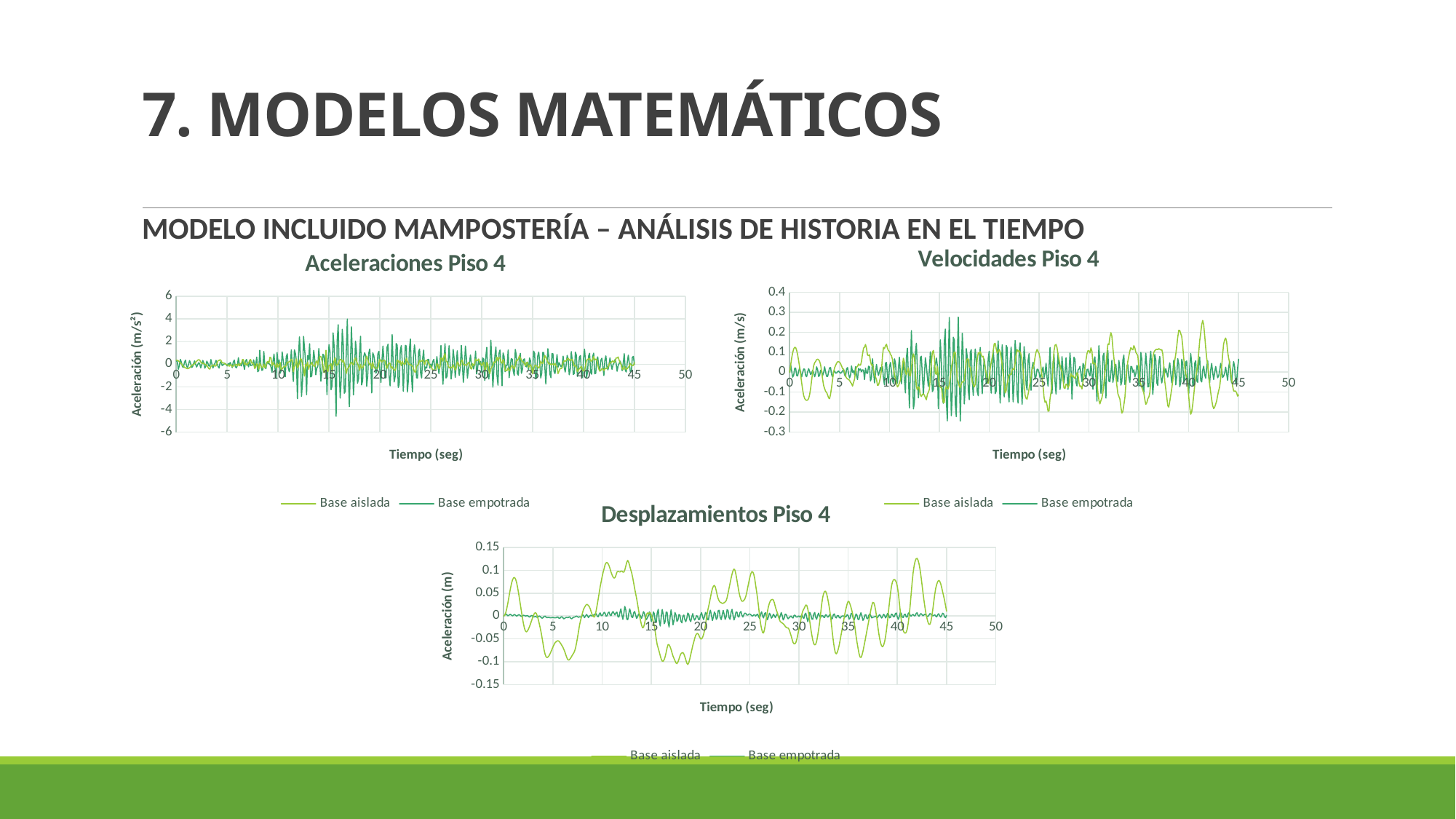
What is the x-axis title of the "Aceleraciones Piso 4" chart? Tiempo (seg) How many series does the legend of "Velocidades Piso 4" list? 2 What is the highest tick value on the x-axis of "Desplazamientos Piso 4"? 50 In "Aceleraciones Piso 4", is the highest peak of Base empotrada greater or less than 2? greater In "Desplazamientos Piso 4", is the highest peak of Base empotrada greater or less than 0.05? less In "Desplazamientos Piso 4", is the highest peak of Base aislada greater or less than 0.1? greater In "Desplazamientos Piso 4", which series reaches the larger peak amplitude, Base aislada or Base empotrada? Base aislada In "Aceleraciones Piso 4", which series reaches the larger peak amplitude, Base aislada or Base empotrada? Base empotrada What is the highest tick value on the y-axis of "Velocidades Piso 4"? 0.4 What are the two series named in the legend of "Desplazamientos Piso 4"? Base aislada and Base empotrada What kind of chart is "Aceleraciones Piso 4"? Line chart